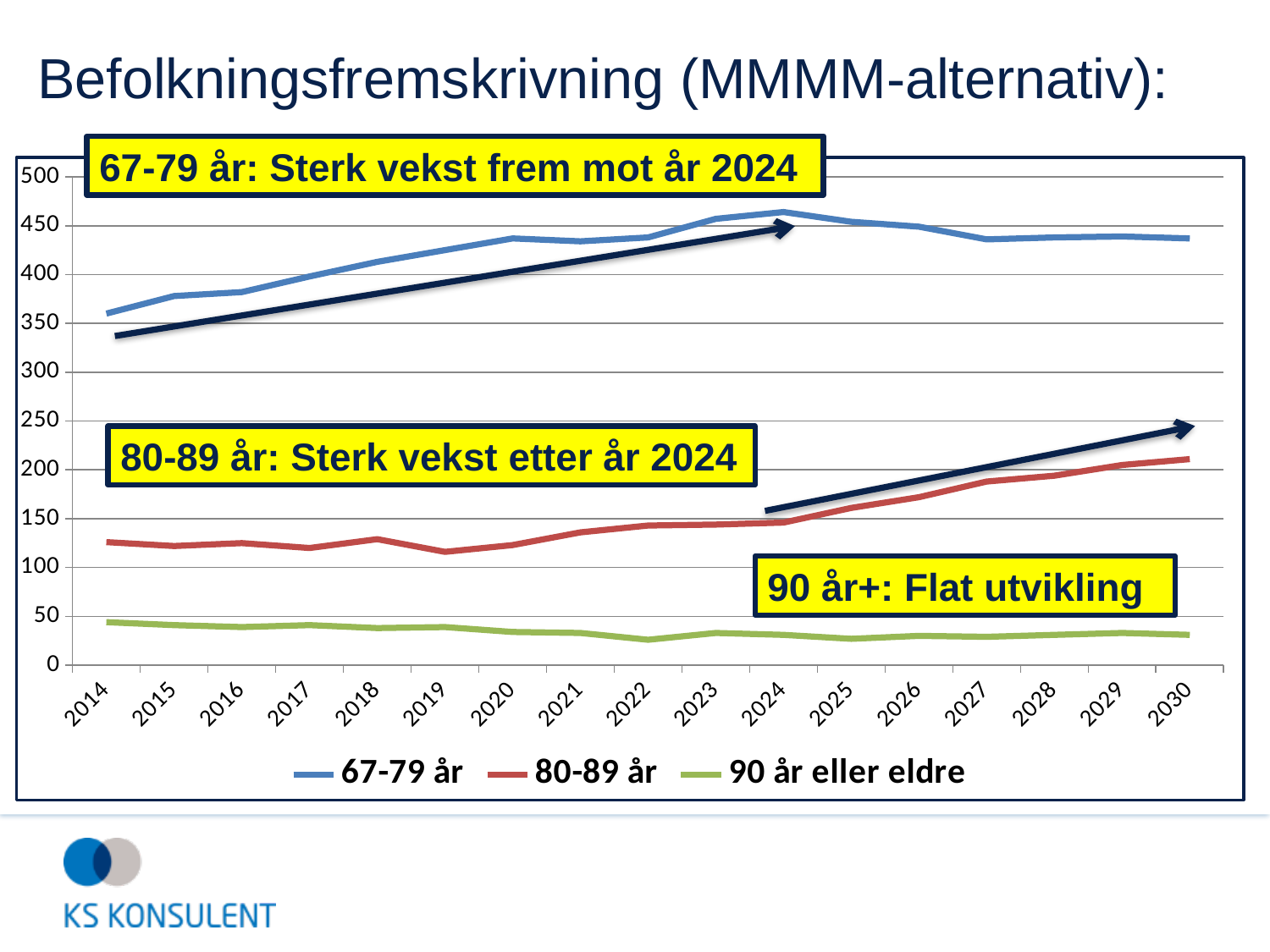
Does the 80-89 år series rise or fall between 2024 and 2030? rise How many series does the legend list? 3 Is the value for 67-79 år in 2024 greater or less than 400? greater What kind of chart is shown on the slide? Line chart Is the value for 80-89 år in 2030 greater or less than 200? greater How many years are shown along the x axis? 17 Which series has the lowest values across the whole period? 90 år eller eldre Is the value for 90 år eller eldre in 2014 greater or less than 50? less Which is larger in 2020, the value for 67-79 år or the value for 80-89 år? 67-79 år What is the title of the slide? Befolkningsfremskrivning (MMMM-alternativ): Which series has the highest value in 2030? 67-79 år